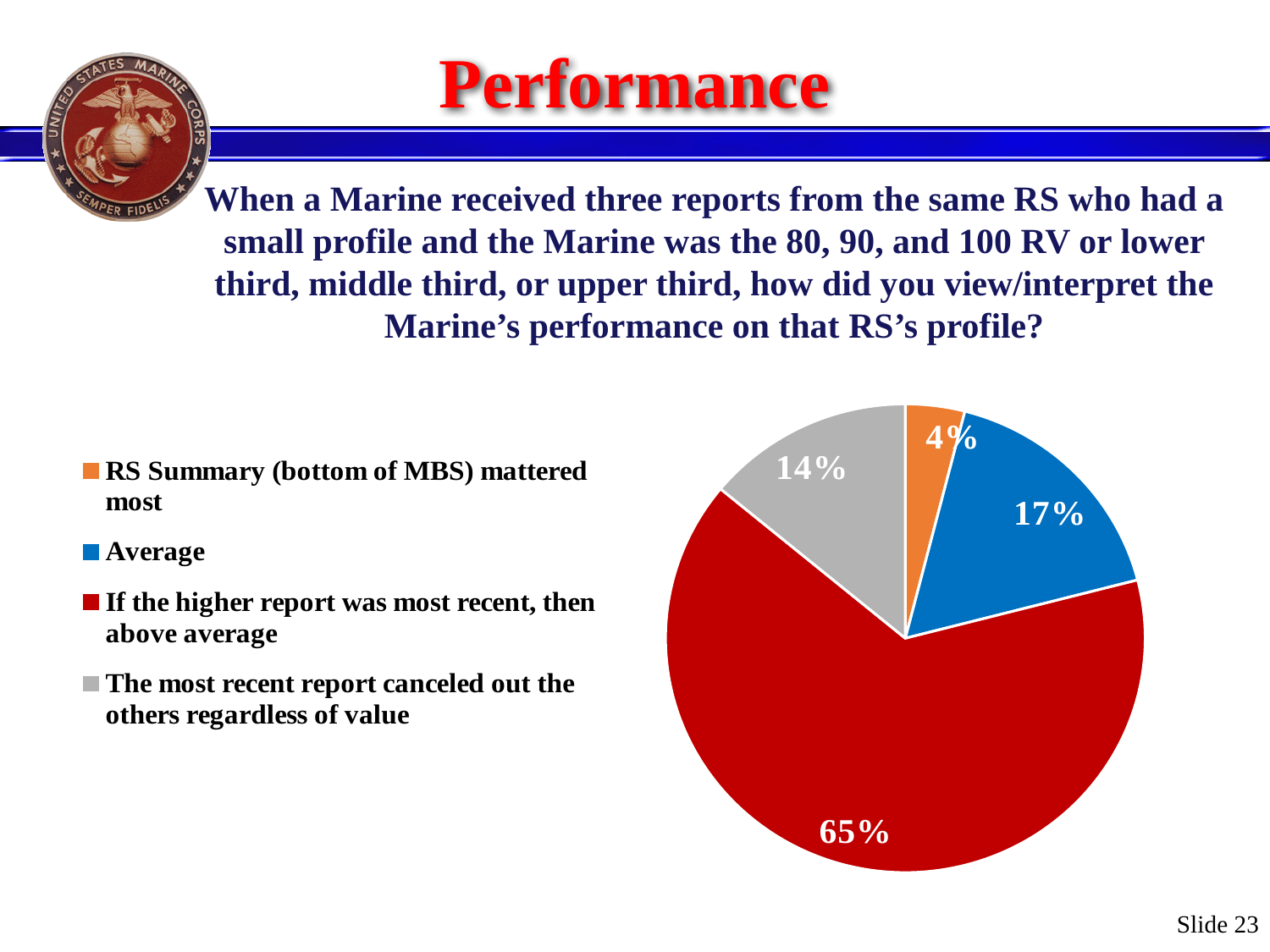
Which response has the smallest share of the pie? RS Summary (bottom of MBS) mattered most What percentage of respondents answered "RS Summary (bottom of MBS) mattered most"? 4% Which response has the largest share of the pie? If the higher report was most recent, then above average What kind of chart is shown on the slide? Pie chart How many slices does the pie chart have? 4 What percentage of respondents answered "Average"? 17% What is the difference in percentage points between "Average" and "The most recent report canceled out the others regardless of value"? 3 percentage points What colour is the slice for "Average"? Blue What percentage of respondents answered "If the higher report was most recent, then above average"? 65% What percentage of respondents answered "The most recent report canceled out the others regardless of value"? 14% Which is larger: the share for "Average" or the share for "The most recent report canceled out the others regardless of value"? Average How many entries does the legend list? 4